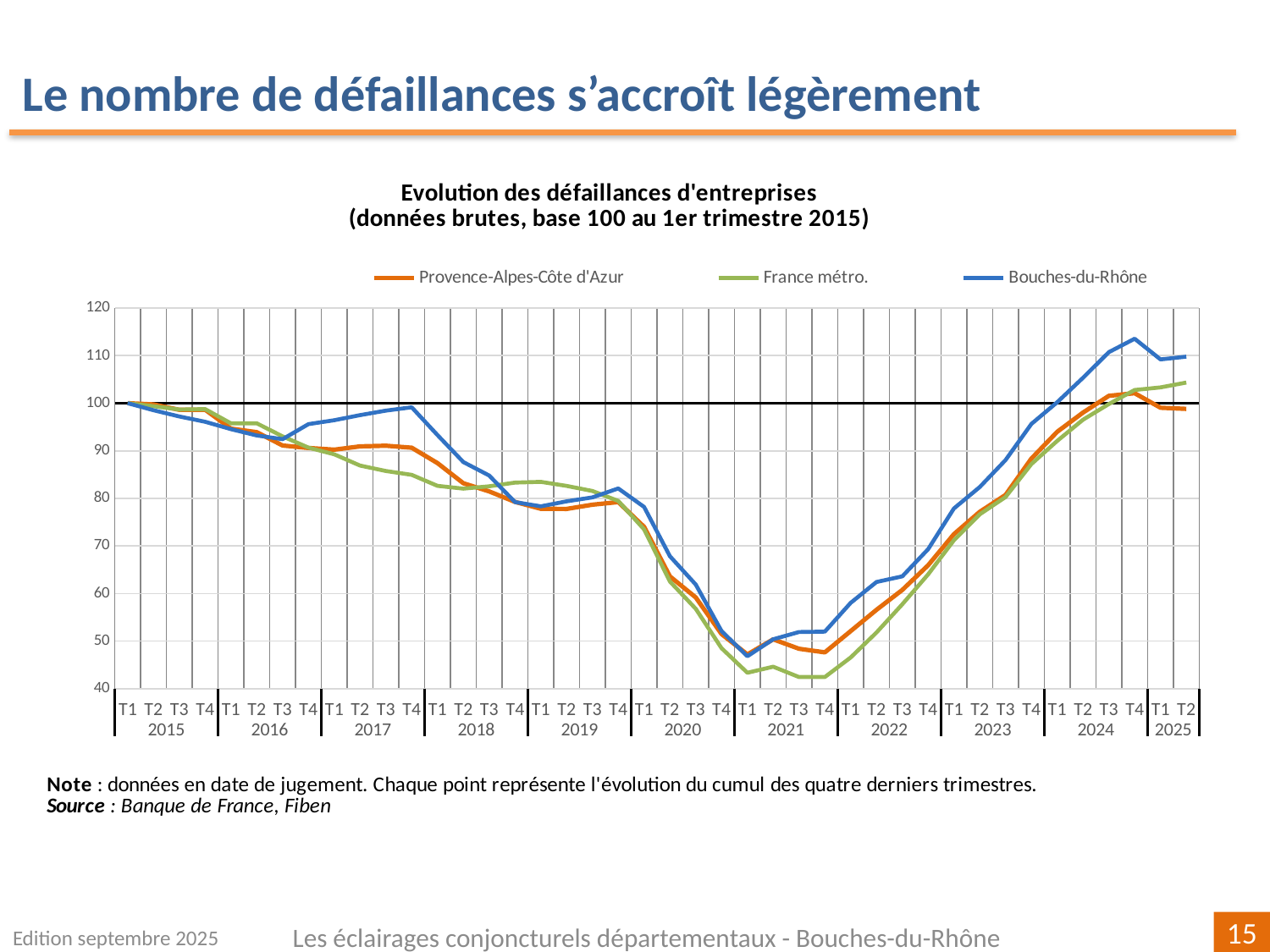
How many series does the legend list? 3 Do the values for Bouches-du-Rhône rise or fall between T1 2021 and T4 2024? rise Which series is drawn in blue? Bouches-du-Rhône Is the value for Provence-Alpes-Côte d'Azur at T4 2021 greater or less than 50? less Which series has the highest value at T2 2025? Bouches-du-Rhône What is the value of each series at T1 2015? 100 What is the title of the chart? Evolution des défaillances d'entreprises (données brutes, base 100 au 1er trimestre 2015) Is the value for Bouches-du-Rhône at T4 2024 greater or less than 110? greater Which series has the lowest value at T1 2021? France métro. Is the value for France métro. at T1 2021 greater or less than 50? less What kind of chart is shown on the slide? line chart